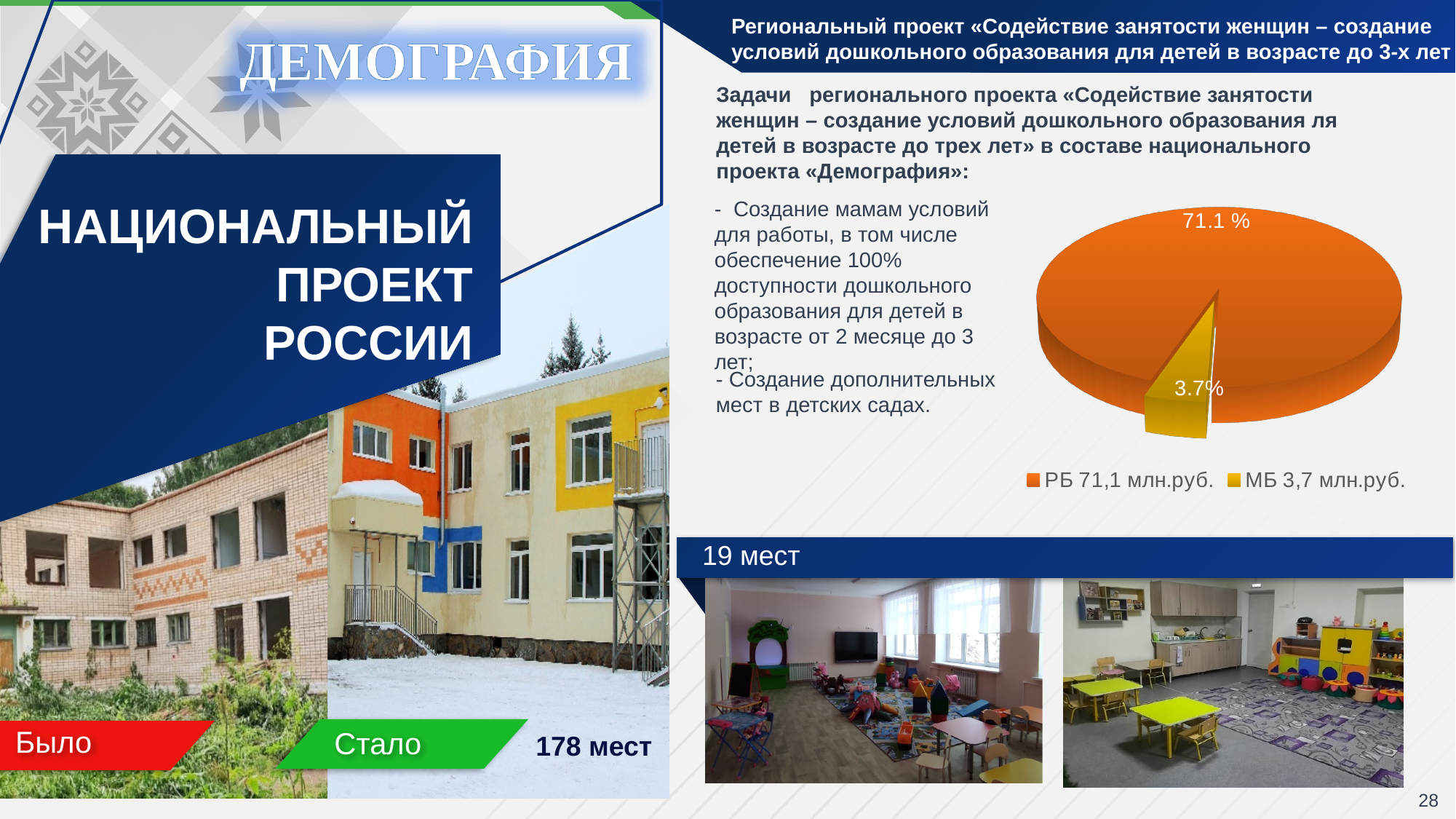
What colour is the МБ slice in the pie chart? yellow What data label is shown on the orange slice of the pie chart? 71.1 % What amount in млн.руб. does the legend give for МБ? 3,7 млн.руб. Which legend entry corresponds to the largest slice of the pie chart? РБ 71,1 млн.руб. How many slices does the pie chart have? 2 How many entries does the legend of the pie chart list? 2 What data label is shown on the yellow slice of the pie chart? 3.7% Which slice is larger in the pie chart, РБ or МБ? РБ What kind of chart is shown on the slide? pie chart Which legend entry corresponds to the smallest slice of the pie chart? МБ 3,7 млн.руб. What amount in млн.руб. does the legend give for РБ? 71,1 млн.руб. What colour is the РБ slice in the pie chart? orange